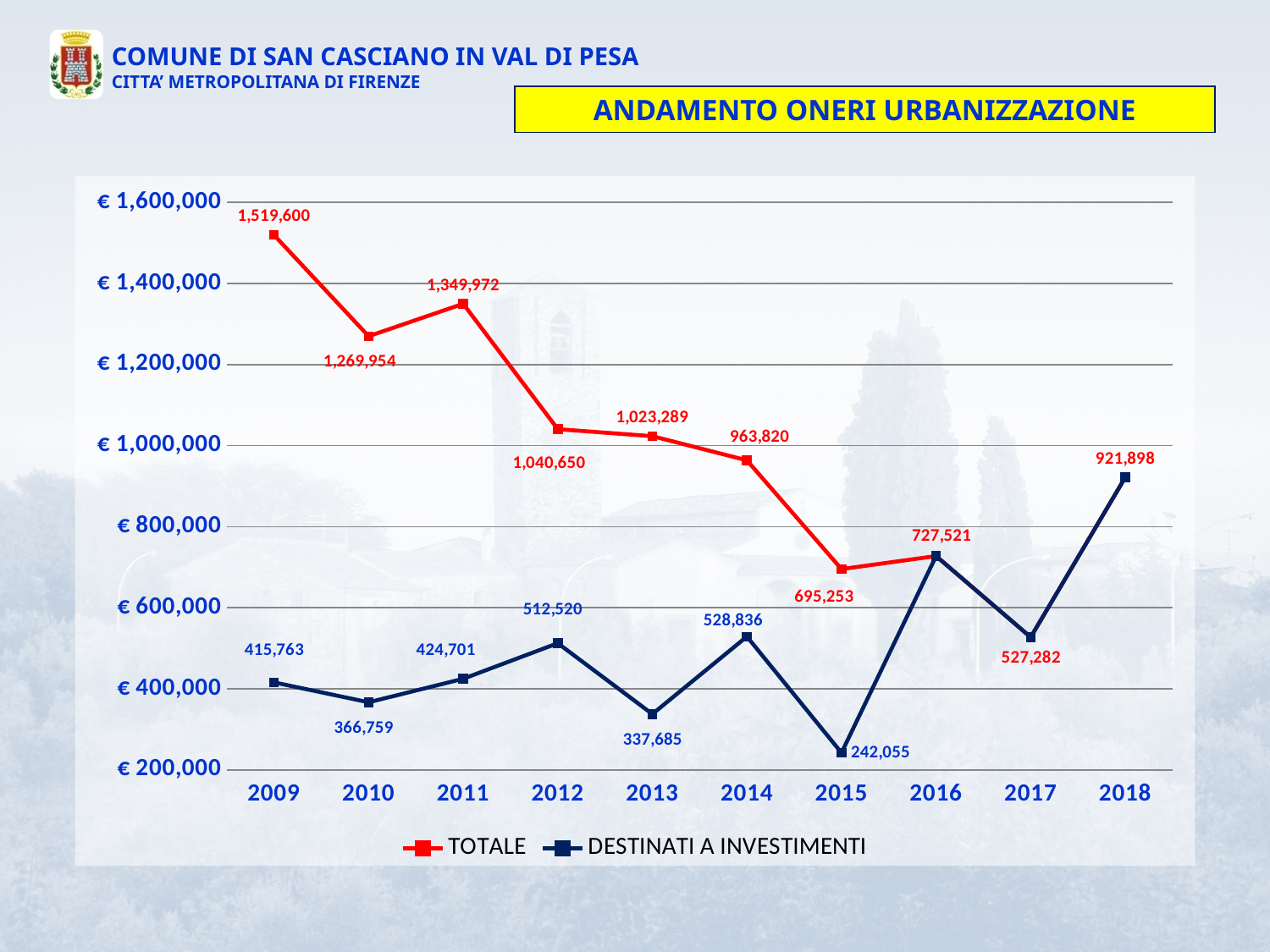
Which year has the larger DESTINATI A INVESTIMENTI value, 2011 or 2013? 2011 Is the TOTALE value for 2014 greater or less than 1,000,000? less Does the TOTALE series generally rise or fall from 2009 to 2015? fall What is the TOTALE value for 2015? 695,253 What is the DESTINATI A INVESTIMENTI value for 2012? 512,520 In which year is the TOTALE series at its highest? 2009 What is the difference between the TOTALE values for 2009 and 2010? 249,646 What kind of chart is shown on the slide? line chart How many series does the legend list? 2 What is the TOTALE value for 2009? 1,519,600 In which year does the DESTINATI A INVESTIMENTI series reach its lowest value? 2015 How many years are shown on the x axis? 10